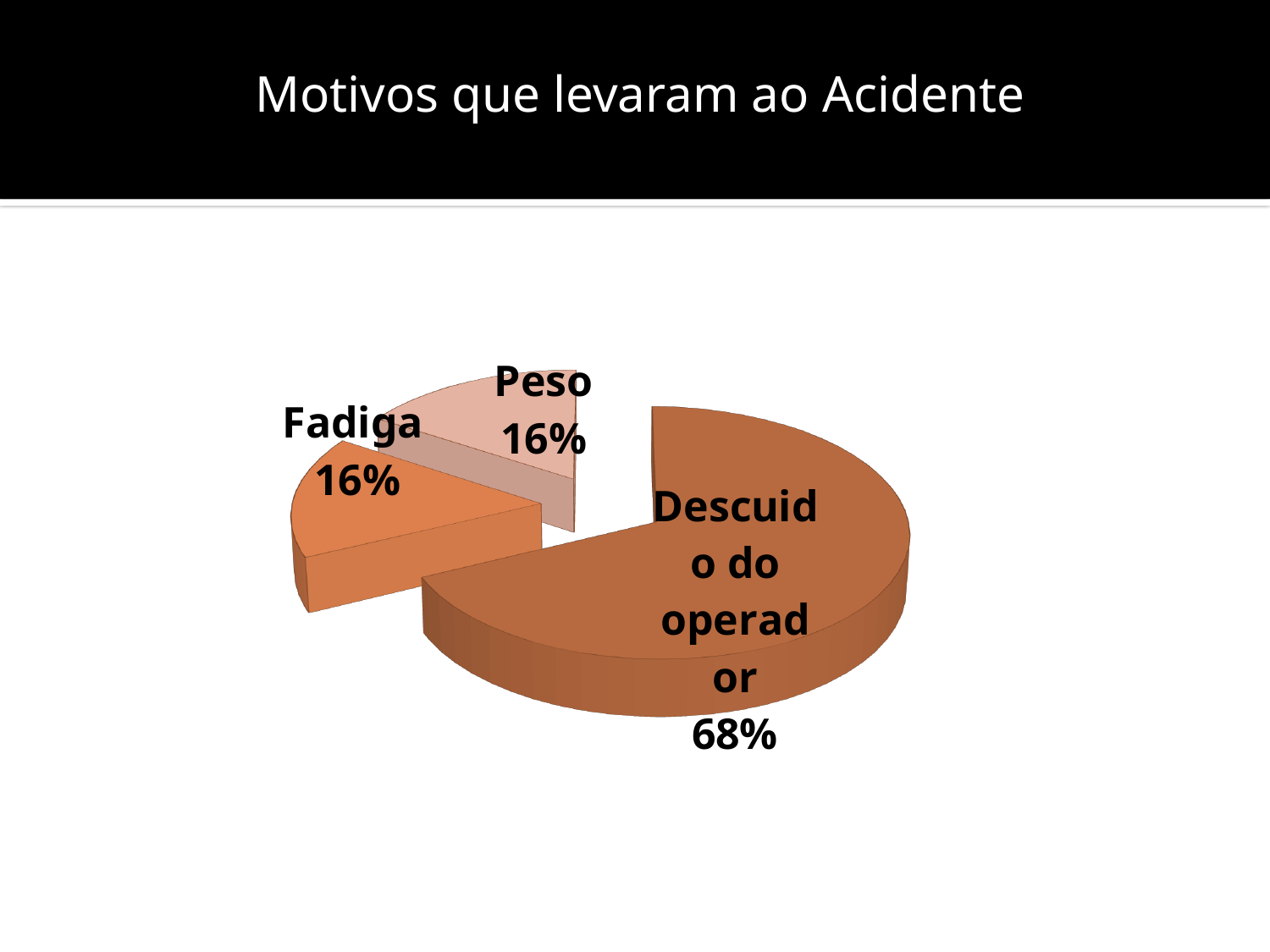
Which is larger, the slice for "Descuido do operador" or the slice for "Peso"? Descuido do operador How many slices does the pie chart have? 3 What share of the pie does "Peso" represent? 16% What share of the pie does "Descuido do operador" represent? 68% What share of the pie does "Fadiga" represent? 16% Which two categories have the same share of the pie? Fadiga and Peso What is the combined share of "Fadiga" and "Peso"? 32% Which category has the largest slice of the pie? Descuido do operador What kind of chart is shown on the slide? pie chart What is the difference in percentage points between "Descuido do operador" and "Fadiga"? 52 What is the title of the slide containing the pie chart? Motivos que levaram ao Acidente